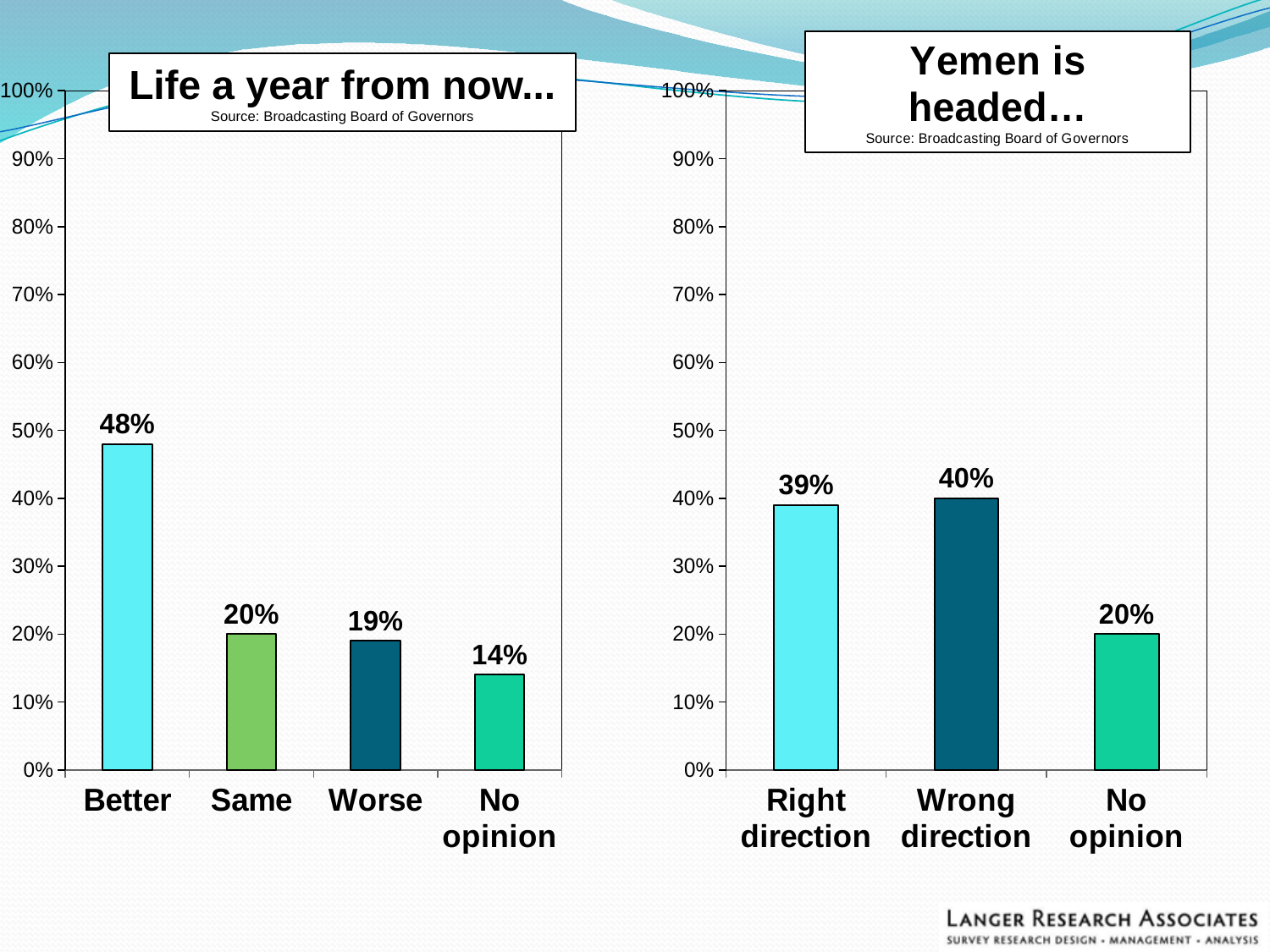
In the 'Yemen is headed…' chart, what is the value for Right direction? 39% In the 'Yemen is headed…' chart, what is the value for Wrong direction? 40% In the 'Life a year from now...' chart, what is the difference between Better and Worse? 29% What source is cited for the 'Life a year from now...' chart? Broadcasting Board of Governors In the 'Life a year from now...' chart, how many categories are shown? 4 In the 'Yemen is headed…' chart, which category has the lowest value? No opinion In the 'Life a year from now...' chart, what is the value for No opinion? 14% In the 'Life a year from now...' chart, which category has the highest value? Better What kind of chart is the 'Yemen is headed…' chart? Bar chart In the 'Life a year from now...' chart, which category has the lowest value? No opinion In the 'Life a year from now...' chart, what is the value for Better? 48% In the 'Yemen is headed…' chart, what is the difference between Wrong direction and No opinion? 20%